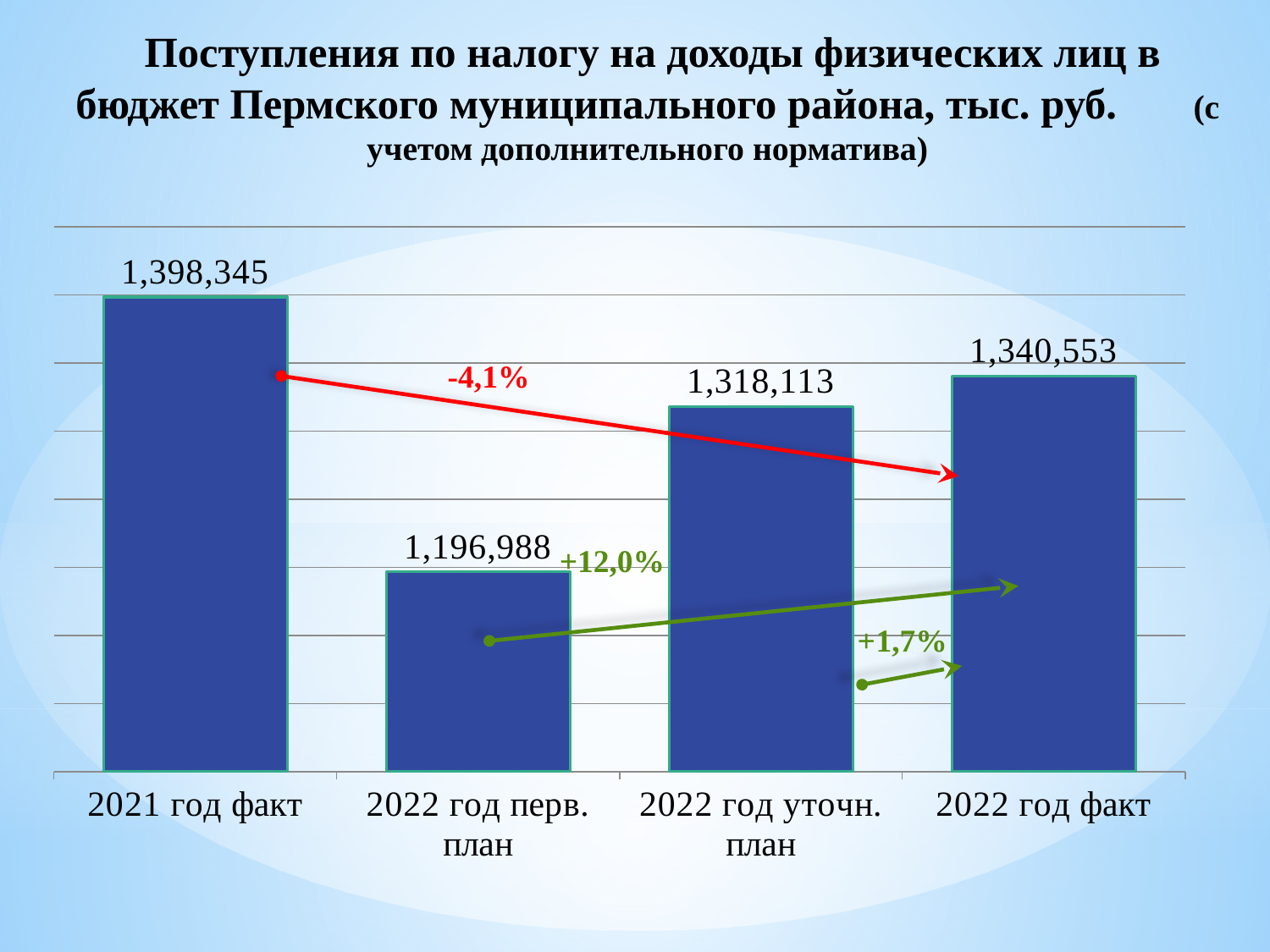
What is the difference between the values for 2021 год факт and 2022 год перв. план? 201,357 What is the value for 2022 год факт? 1,340,553 Which is larger, the value for 2022 год уточн. план or the value for 2022 год факт? 2022 год факт What is the value for 2021 год факт? 1,398,345 What is the value for 2022 год уточн. план? 1,318,113 What percentage change is shown by the red arrow from 2021 год факт to 2022 год факт? -4,1% Which category has the lowest value? 2022 год перв. план Which category has the highest value? 2021 год факт How many categories are shown on the chart? 4 What is the difference between the values for 2022 год факт and 2022 год уточн. план? 22,440 What kind of chart is shown on the slide? bar chart What is the value for 2022 год перв. план? 1,196,988